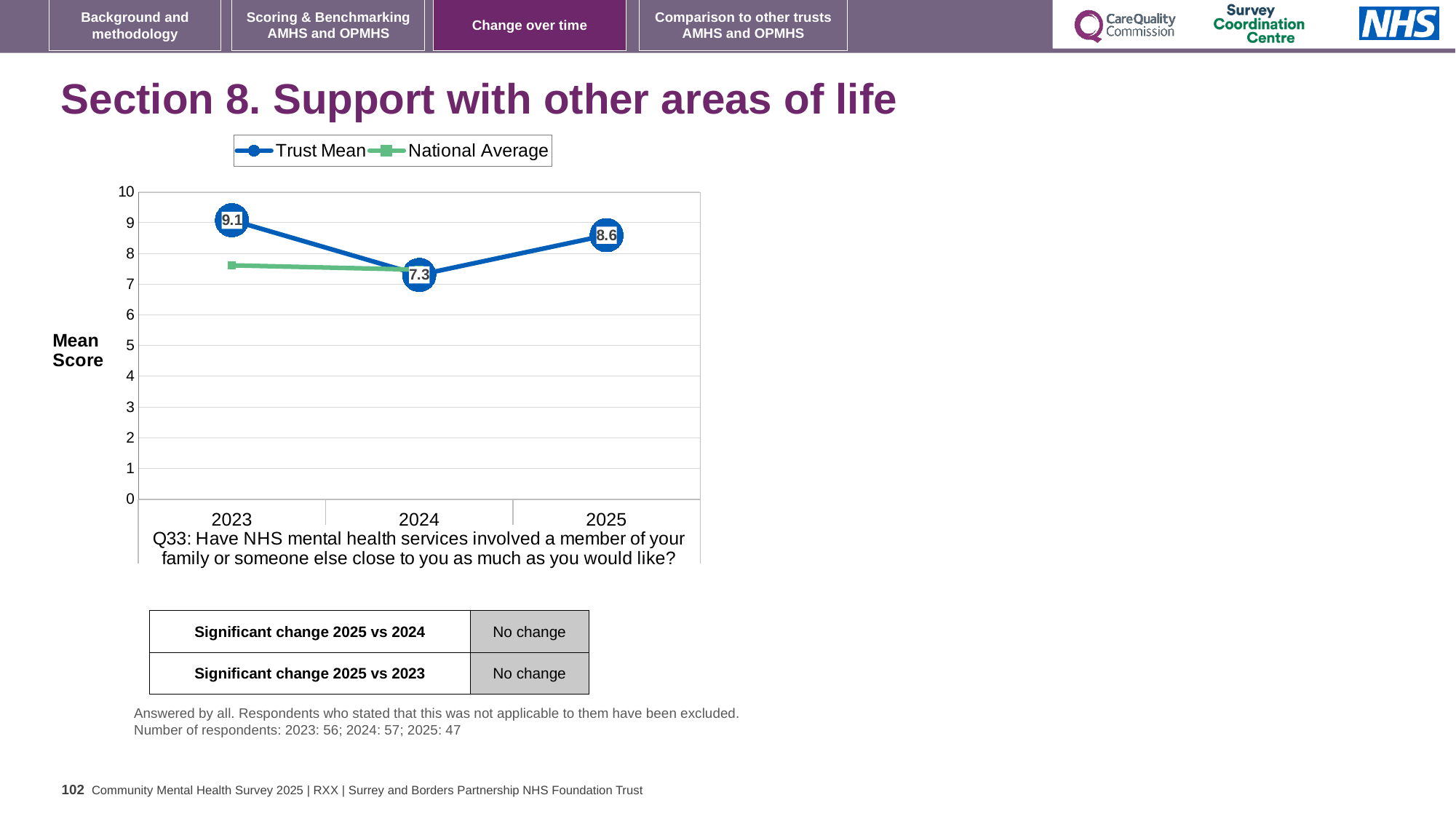
Does the Trust Mean rise or fall from 2023 to 2024? Fall What kind of chart is shown on the slide? Line chart What is the Trust Mean score for 2025? 8.6 Is the National Average value for 2023 greater or less than 7? greater What is the Trust Mean score for 2023? 9.1 In which year is the Trust Mean lowest? 2024 Which is larger, the Trust Mean in 2025 or the Trust Mean in 2024? 2025 How many series does the legend list? 2 In which year is the Trust Mean highest? 2023 How many years are shown on the x axis? 3 What is the Trust Mean score for 2024? 7.3 What is the difference between the Trust Mean in 2023 and in 2024? 1.8